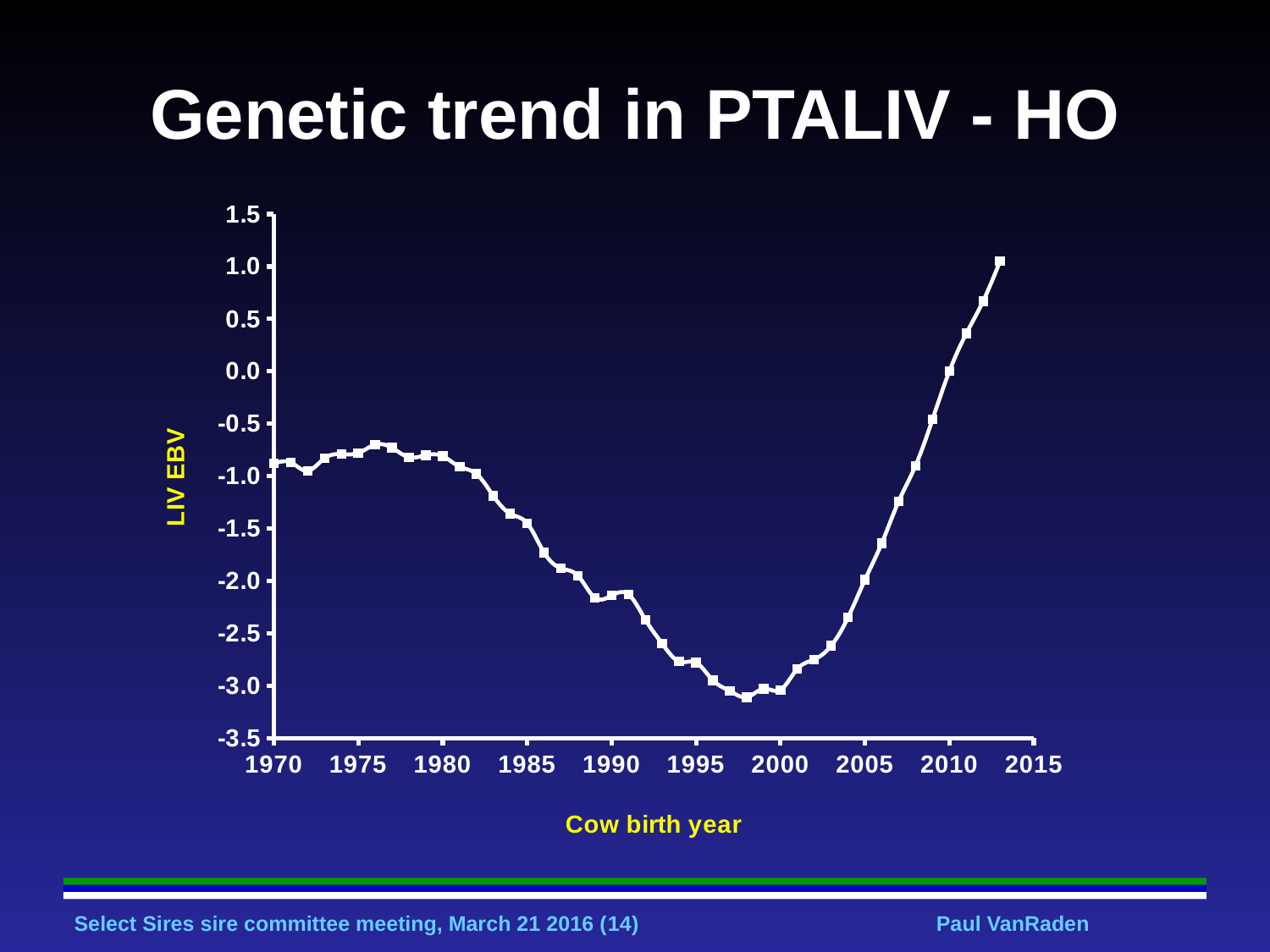
Is the LIV EBV value for 2000 greater or less than -2.5? less Is the LIV EBV value for 2005 greater or less than -1.5? less What is the title of the chart? Genetic trend in PTALIV - HO How many lines are plotted on the chart? 1 What kind of chart is shown on the slide? line chart Which has the larger LIV EBV value, cow birth year 1975 or cow birth year 1995? 1975 What is the label on the x axis of the chart? Cow birth year Between cow birth years 2000 and 2013, does the LIV EBV line rise or fall? rise Is the LIV EBV value for 1970 greater or less than -0.5? less Between cow birth years 1980 and 1995, does the LIV EBV line rise or fall? fall